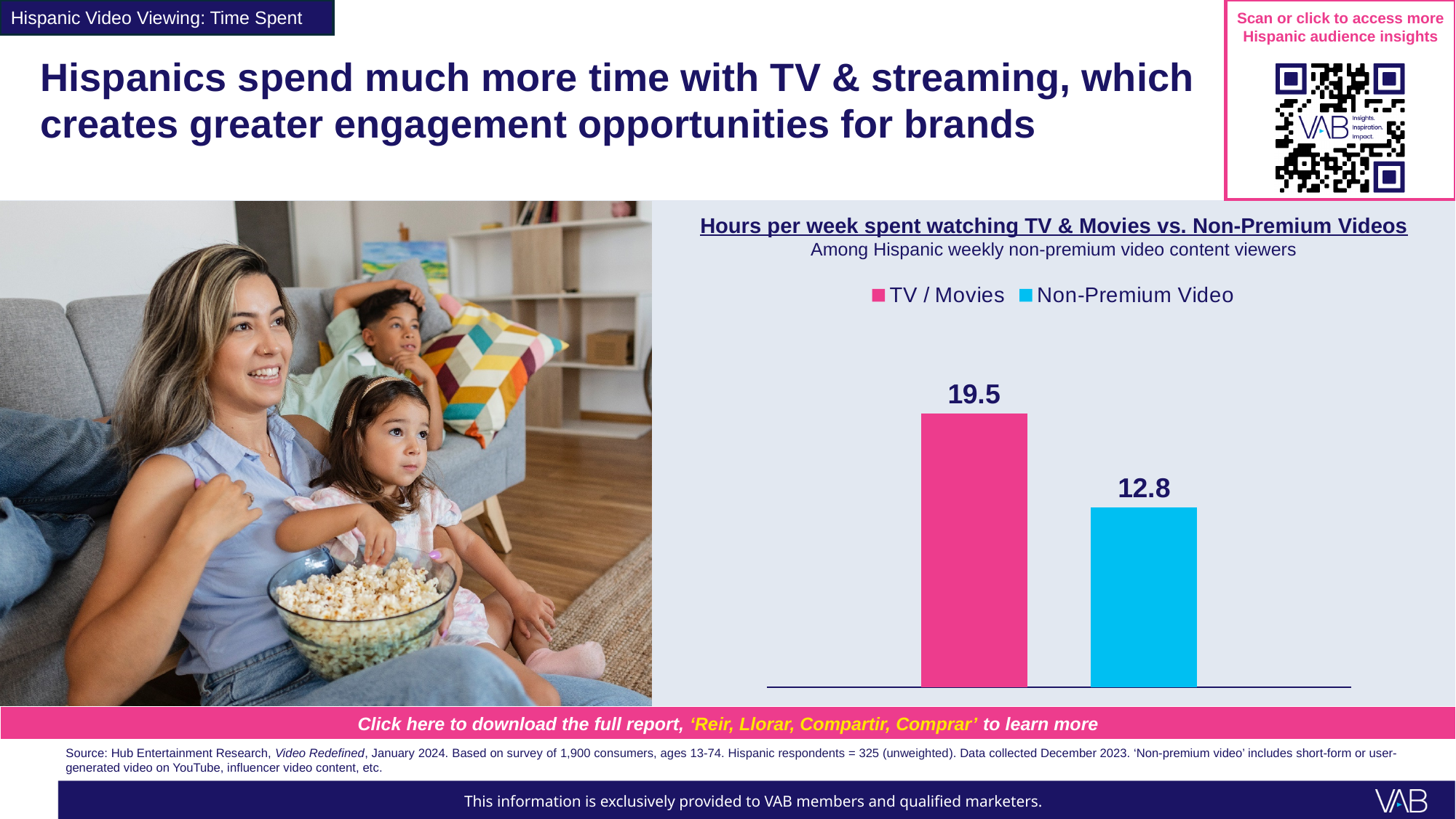
Which category has the higher value in the chart? TV / Movies How many entries does the chart legend list? 2 Is the value for TV / Movies larger or smaller than the value for Non-Premium Video? larger What colour is the bar for Non-Premium Video? blue What is the difference in hours per week between TV / Movies and Non-Premium Video? 6.7 How many bars are plotted in the chart? 2 How many hours per week do Hispanic viewers spend watching Non-Premium Video according to the chart? 12.8 What is the title of the chart? Hours per week spent watching TV & Movies vs. Non-Premium Videos What kind of chart is shown on the slide? bar chart Which category has the lower value in the chart? Non-Premium Video How many hours per week do Hispanic viewers spend watching TV / Movies according to the chart? 19.5